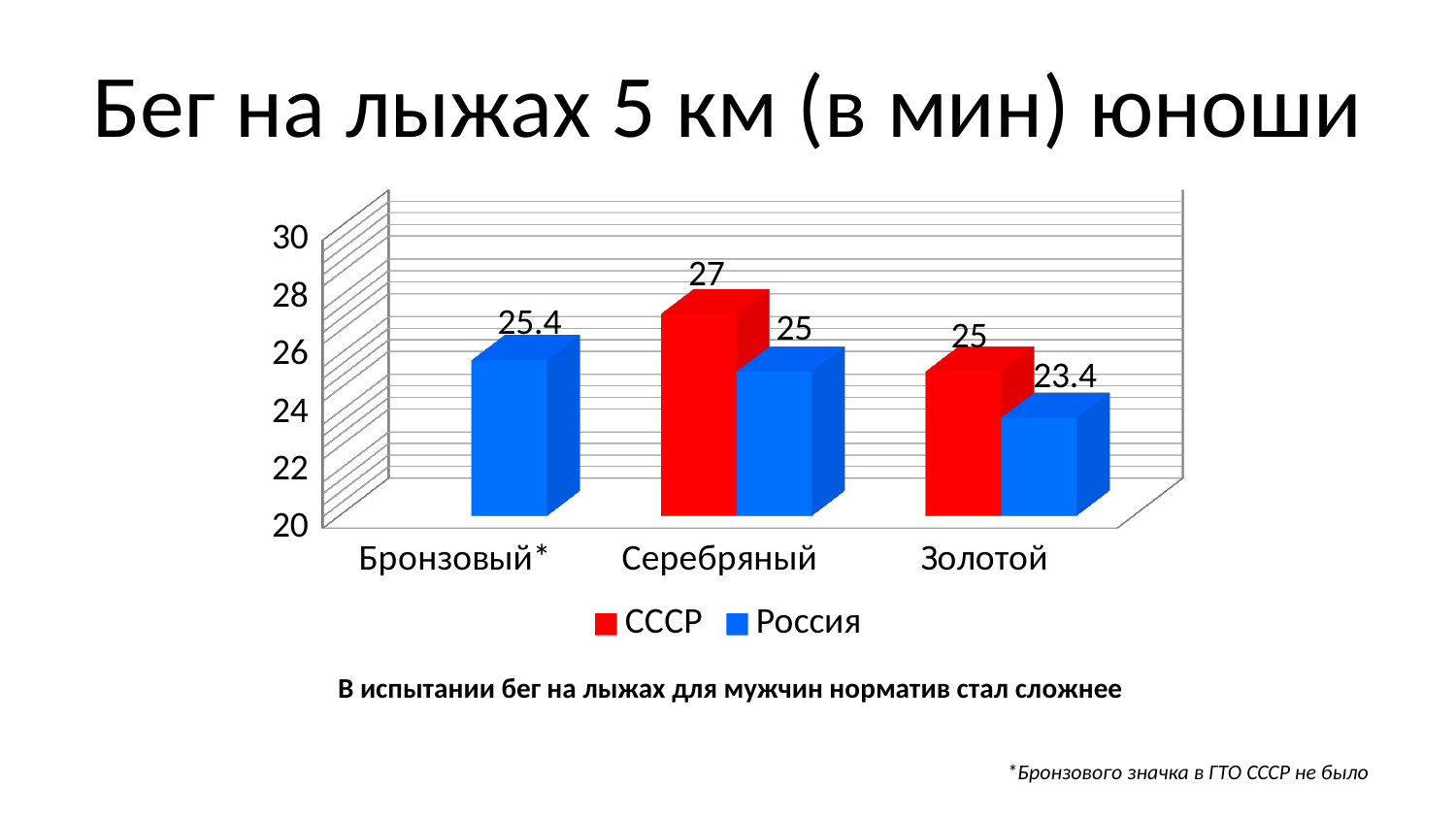
What is the value for Россия in the Золотой category? 23.4 In the Золотой category, which series has the larger value, СССР or Россия? СССР Which category has the lowest value for the Россия series? Золотой How many series does the legend list? 2 What is the value for Россия in the Бронзовый category? 25.4 What kind of chart is shown on the slide? Bar chart Which colour represents the Россия series? Blue What is the value for СССР in the Золотой category? 25 What is the difference between the Россия values for Бронзовый and Золотой? 2 Which category has the highest value for the СССР series? Серебряный What is the value for Россия in the Серебряный category? 25 What is the difference between the СССР and Россия values in the Серебряный category? 2